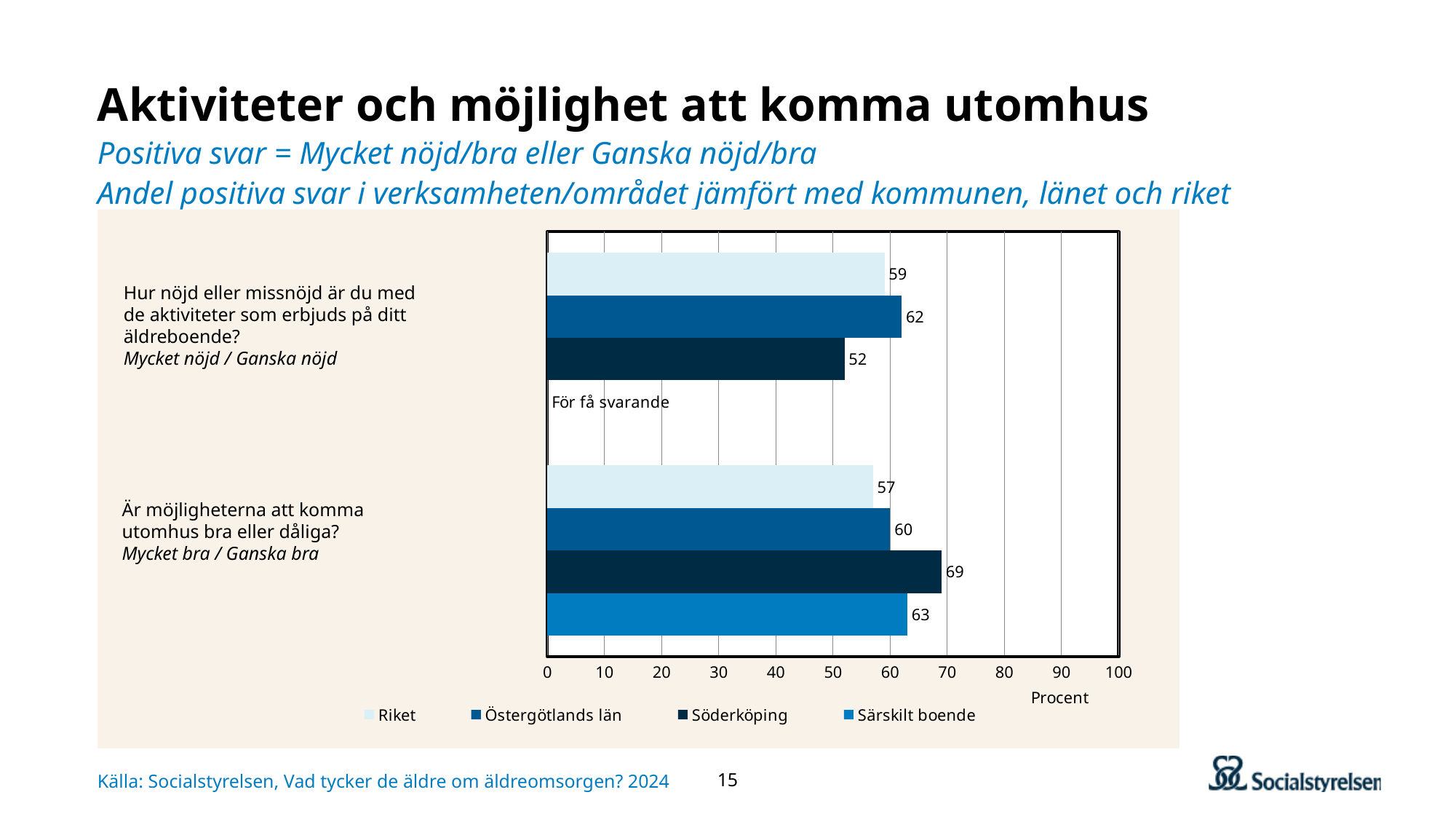
What kind of chart is shown on the slide? Bar chart Which is larger for the question about opportunities to get outdoors: Riket or Östergötlands län? Östergötlands län What is the value for Riket for the question about satisfaction with activities offered at the care home (Hur nöjd eller missnöjd är du med de aktiviteter som erbjuds på ditt äldreboende?)? 59 What is the difference between Östergötlands län and Söderköping for the question about satisfaction with activities offered? 10 What is shown for Särskilt boende for the question about satisfaction with activities offered? För få svarande What is the value for Söderköping for the question about opportunities to get outdoors (Är möjligheterna att komma utomhus bra eller dåliga?)? 69 What unit is shown on the x axis of the chart? Procent What is the difference between Söderköping and Riket for the question about opportunities to get outdoors? 12 What is the value for Särskilt boende for the question about opportunities to get outdoors? 63 Which series has the highest value for the question about opportunities to get outdoors? Söderköping Which series has the lowest value for the question about satisfaction with activities offered? Söderköping How many series does the legend list? 4